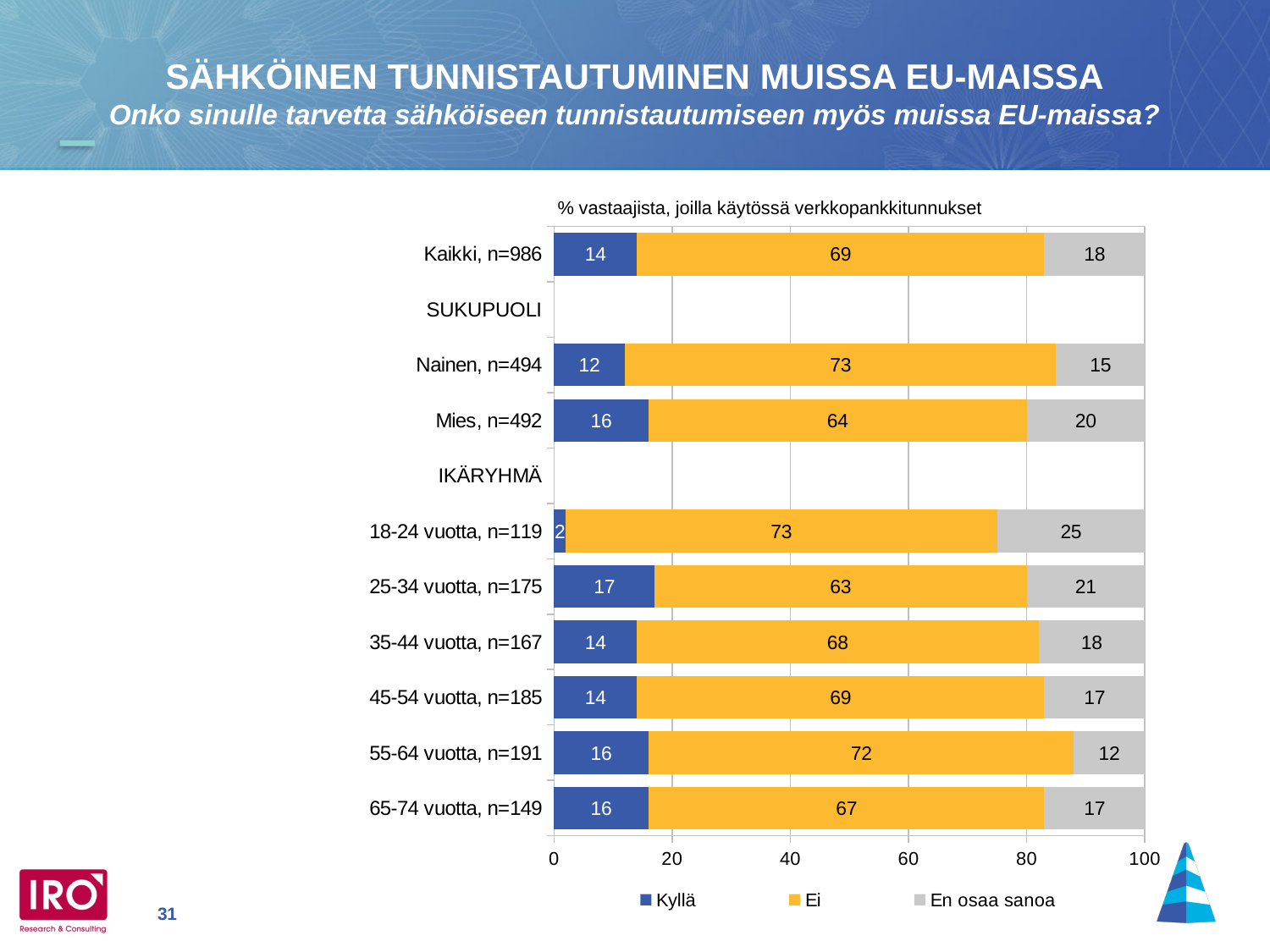
What is the value of "Kyllä" for "Mies, n=492"? 16 What is the value of "Ei" for "Kaikki, n=986"? 69 Which group has the lowest "Kyllä" value? 18-24 vuotta, n=119 Which series is shown in yellow in the legend? Ei Which group has the highest "Kyllä" value? 25-34 vuotta, n=175 What is the total of the stacked bar for "Kaikki, n=986"? 101 Which is larger: the "En osaa sanoa" value for "55-64 vuotta, n=191" or for "65-74 vuotta, n=149"? 65-74 vuotta, n=149 How many groups have bars plotted in the chart? 9 How many series does the legend list? 3 What kind of chart is shown on the slide? Stacked bar chart What is the difference between the "Ei" values for "Nainen, n=494" and "Mies, n=492"? 9 What is the value of "En osaa sanoa" for "18-24 vuotta, n=119"? 25